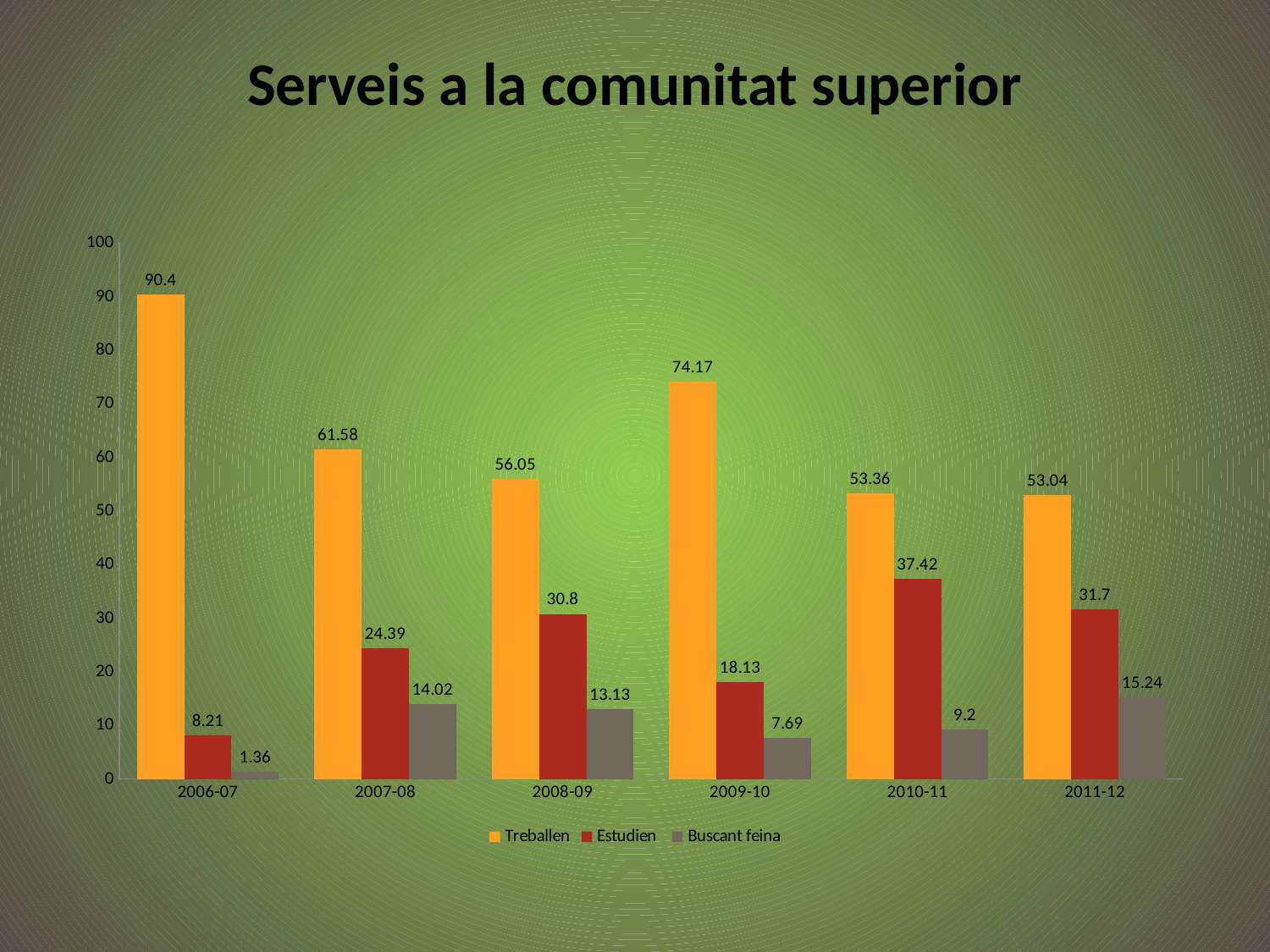
How many series does the legend list? 3 Which is larger in 2008-09: Estudien or Buscant feina? Estudien What is the title of the chart? Serveis a la comunitat superior What is the value for Buscant feina in 2011-12? 15.24 How many years are shown on the x axis? 6 In which year is the Treballen value highest? 2006-07 What is the difference between the Treballen and Estudien values in 2009-10? 56.04 What is the value for Estudien in 2010-11? 37.42 What kind of chart is shown on the slide? bar chart Is the value for Treballen in 2007-08 greater or less than 60? greater In which year is the Buscant feina value lowest? 2006-07 What is the value for Treballen in 2006-07? 90.4